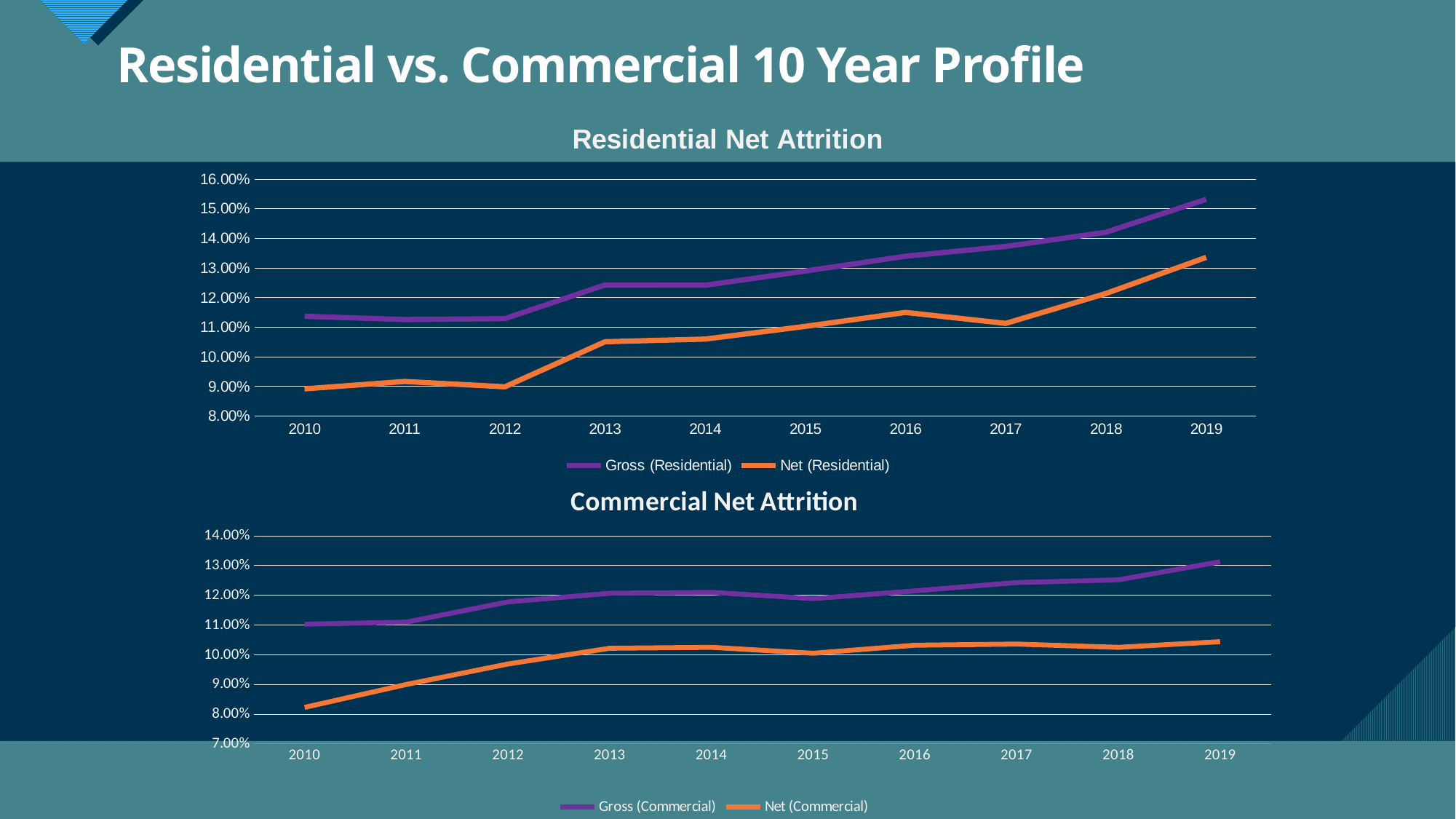
In the Residential Net Attrition chart, does the Gross (Residential) line generally rise or fall from 2010 to 2019? rise How many series does the legend of the Commercial Net Attrition chart list? 2 In the Commercial Net Attrition chart, which year has the lowest Net (Commercial) value? 2010 In the Residential Net Attrition chart, what colour is the Net (Residential) line? orange In the Commercial Net Attrition chart, is the Gross (Commercial) value for 2019 greater or less than 12.00%? greater In the Commercial Net Attrition chart, which is larger in 2015: Gross (Commercial) or Net (Commercial)? Gross (Commercial) What type of chart is the Residential Net Attrition chart? line chart In the Residential Net Attrition chart, is the Net (Residential) value for 2013 greater or less than 10.00%? greater How many years are plotted on the x axis of the Residential Net Attrition chart? 10 In the Residential Net Attrition chart, which year has the highest Gross (Residential) value? 2019 In the Commercial Net Attrition chart, is the Net (Commercial) value for 2010 greater or less than 9.00%? less